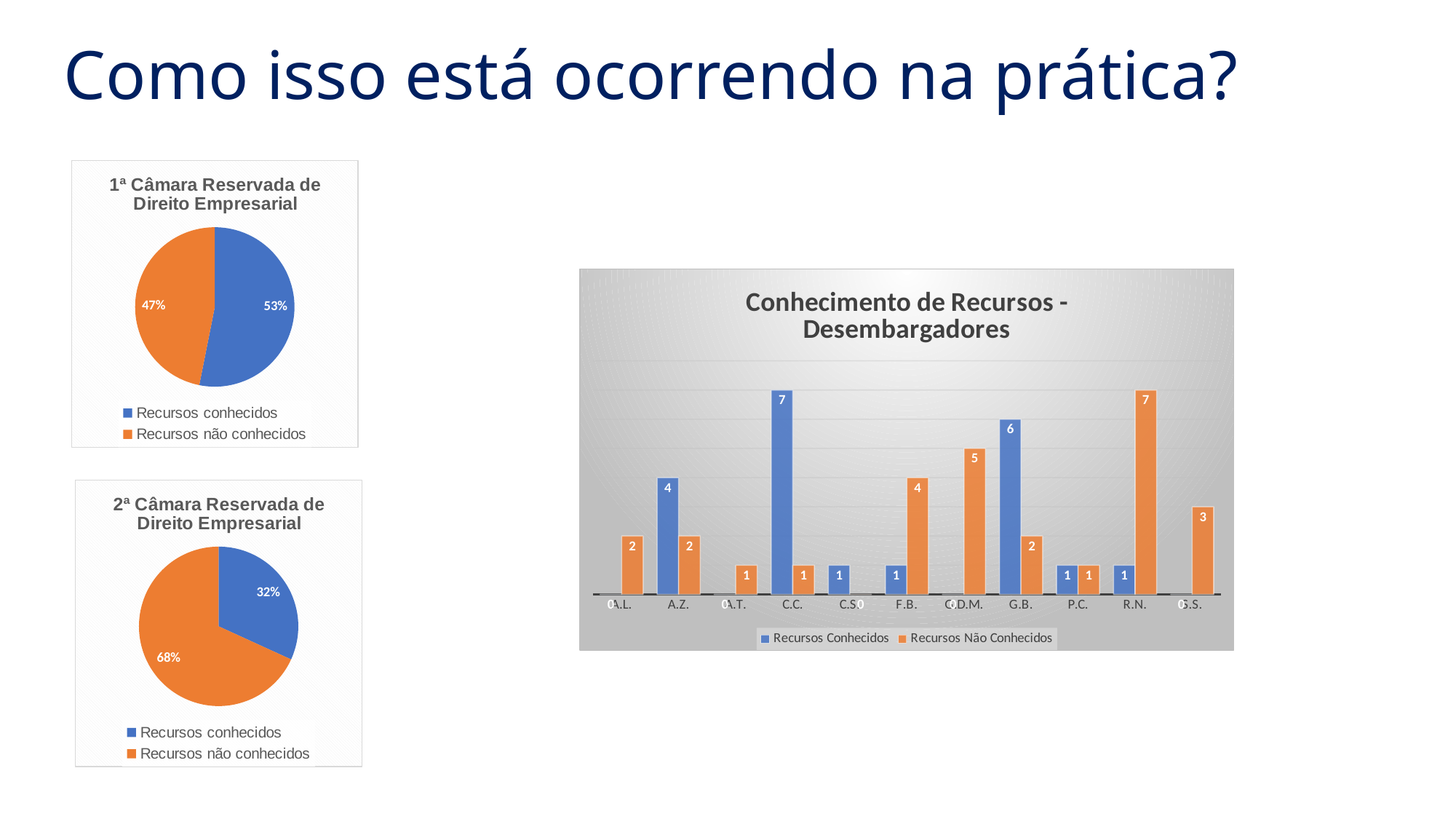
In the bar chart titled 'Conhecimento de Recursos - Desembargadores', what is the value of 'Recursos Conhecidos' for C.C.? 7 In the bar chart titled 'Conhecimento de Recursos - Desembargadores', which category has the highest 'Recursos Conhecidos' value? C.C. In the pie chart titled '2ª Câmara Reservada de Direito Empresarial', what share is 'Recursos não conhecidos'? 68% In the bar chart titled 'Conhecimento de Recursos - Desembargadores', what is the difference between 'Recursos Não Conhecidos' and 'Recursos Conhecidos' for F.B.? 3 In the pie chart titled '1ª Câmara Reservada de Direito Empresarial', what share is 'Recursos conhecidos'? 53% What kind of chart is 'Conhecimento de Recursos - Desembargadores'? Bar chart In the bar chart titled 'Conhecimento de Recursos - Desembargadores', how many categories are shown on the x axis? 11 In the pie chart titled '1ª Câmara Reservada de Direito Empresarial', what is the difference between the 'Recursos conhecidos' and 'Recursos não conhecidos' shares? 6% In the pie chart titled '2ª Câmara Reservada de Direito Empresarial', which slice is larger, 'Recursos conhecidos' or 'Recursos não conhecidos'? Recursos não conhecidos In the bar chart titled 'Conhecimento de Recursos - Desembargadores', which is larger for G.B., 'Recursos Conhecidos' or 'Recursos Não Conhecidos'? Recursos Conhecidos In the bar chart titled 'Conhecimento de Recursos - Desembargadores', how many series does the legend list? 2 In the bar chart titled 'Conhecimento de Recursos - Desembargadores', what is the value of 'Recursos Não Conhecidos' for R.N.? 7